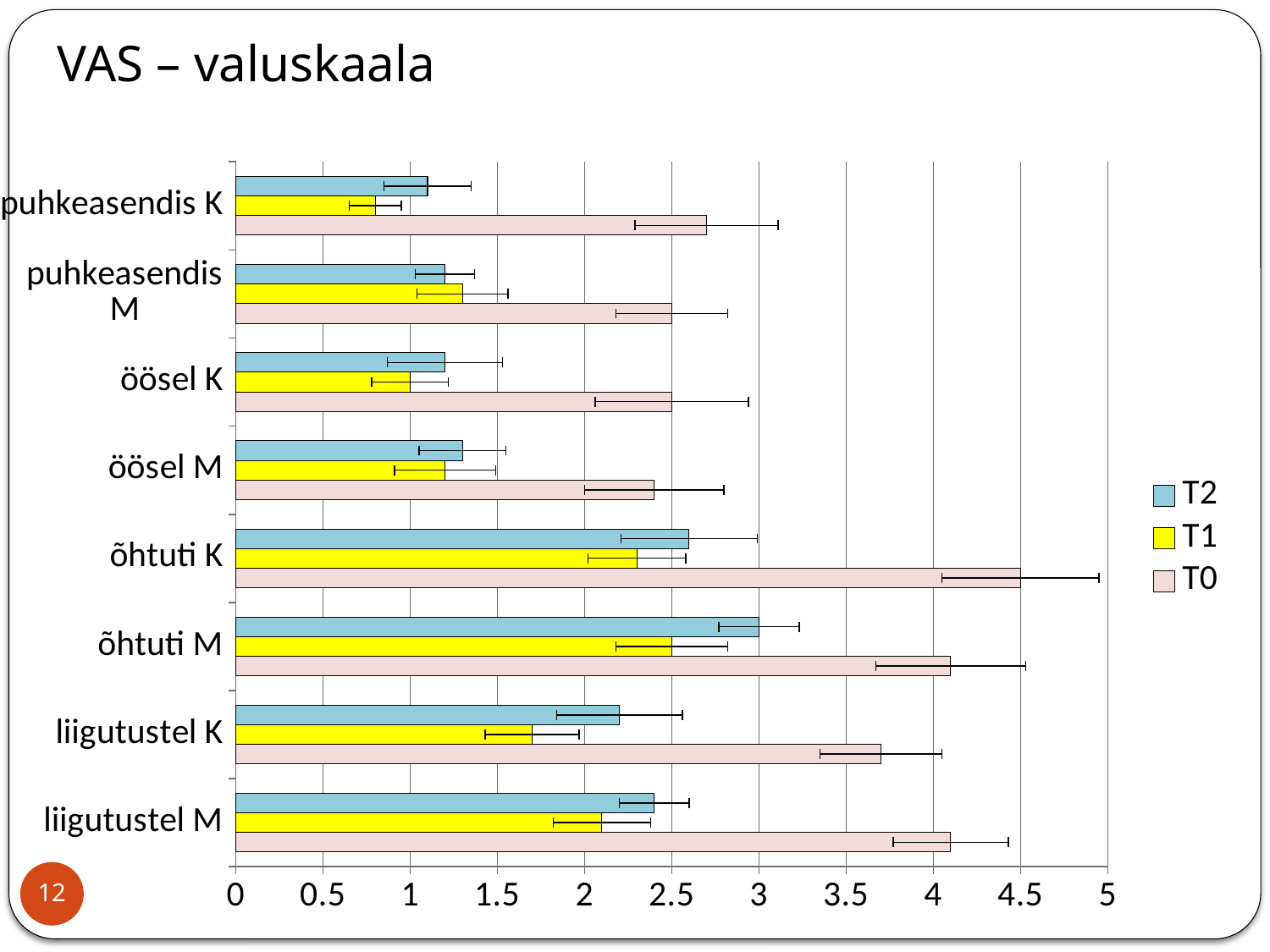
Which category has the highest T0 value? õhtuti K What are the series names listed in the legend? T2, T1, T0 What is the title of the chart? VAS – valuskaala What type of chart is shown on the slide? bar chart Which is larger: the T2 value for õhtuti M or the T2 value for liigutustel M? õhtuti M Which category has the lowest T1 value? puhkeasendis K Is the T0 value for puhkeasendis K greater or less than 2.5? greater How many series does the legend list? 3 Is the T2 value for puhkeasendis K greater or less than 1.5? less What is the T2 value for õhtuti M? 3 How many categories are shown on the vertical axis? 8 What is the T0 value for õhtuti K? 4.5